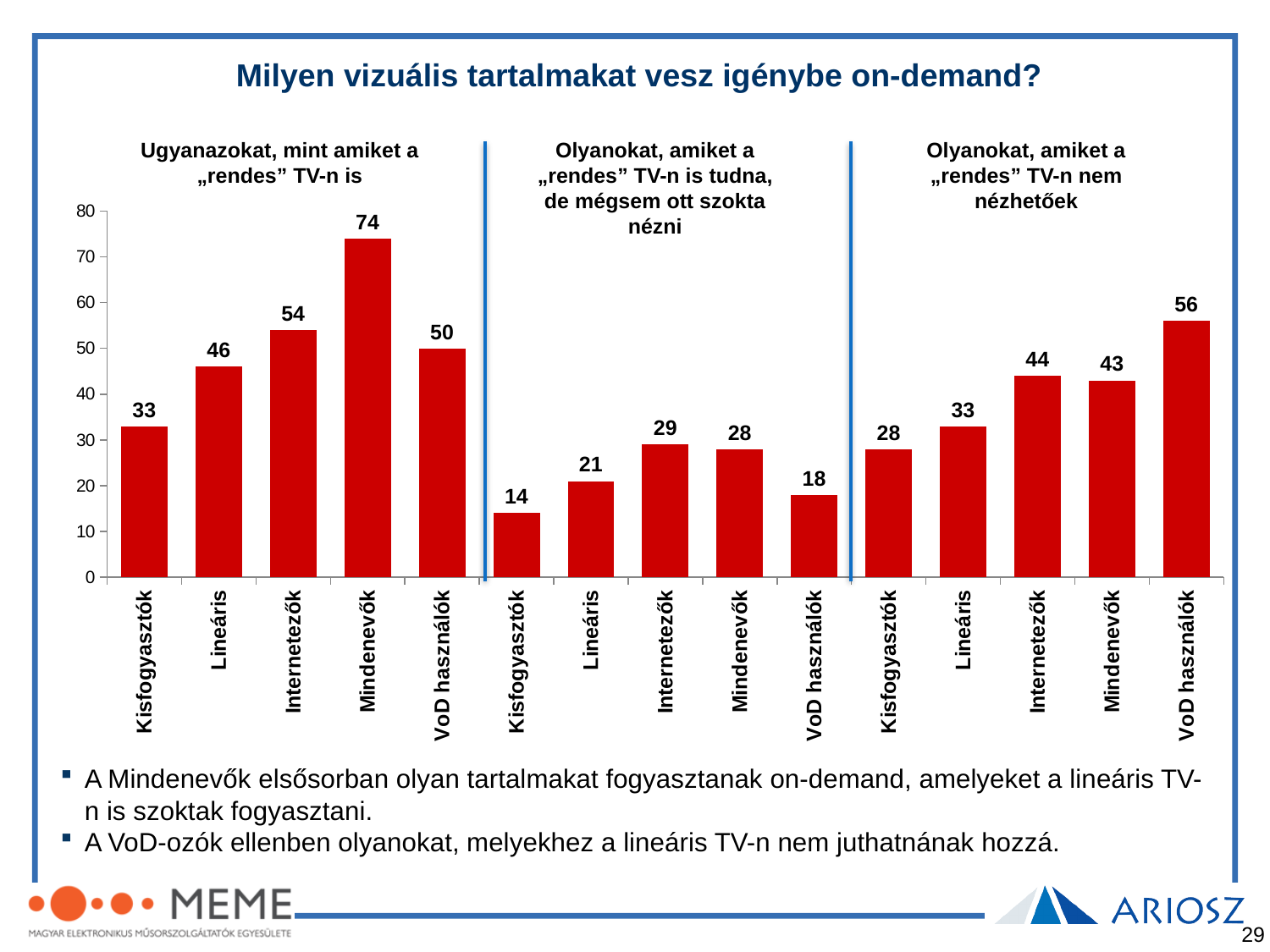
In the group "Olyanokat, amiket a „rendes” TV-n nem nézhetőek", which category has the highest value? VoD használók Is the value for Lineáris in the first group greater or less than 40? greater What type of chart is shown on the slide? bar chart What is the title of the chart? Milyen vizuális tartalmakat vesz igénybe on-demand? What is the value for Kisfogyasztók in the middle group ("Olyanokat, amiket a „rendes” TV-n is tudna, de mégsem ott szokta nézni")? 14 How many bars are plotted in total across the three groups? 15 Which is larger: Internetezők in the first group or Internetezők in the third group? Internetezők in the first group (54) What is the value for VoD használók in the group "Olyanokat, amiket a „rendes” TV-n nem nézhetőek"? 56 What is the difference between the Mindenevők value in the first group (74) and the Mindenevők value in the middle group (28)? 46 Which bar has the lowest value in the whole chart? Kisfogyasztók (Olyanokat, amiket a „rendes” TV-n is tudna, de mégsem ott szokta nézni), 14 Which bar has the highest value in the whole chart? Mindenevők (Ugyanazokat, mint amiket a „rendes” TV-n is), 74 What is the value for Mindenevők in the group "Ugyanazokat, mint amiket a „rendes” TV-n is"? 74